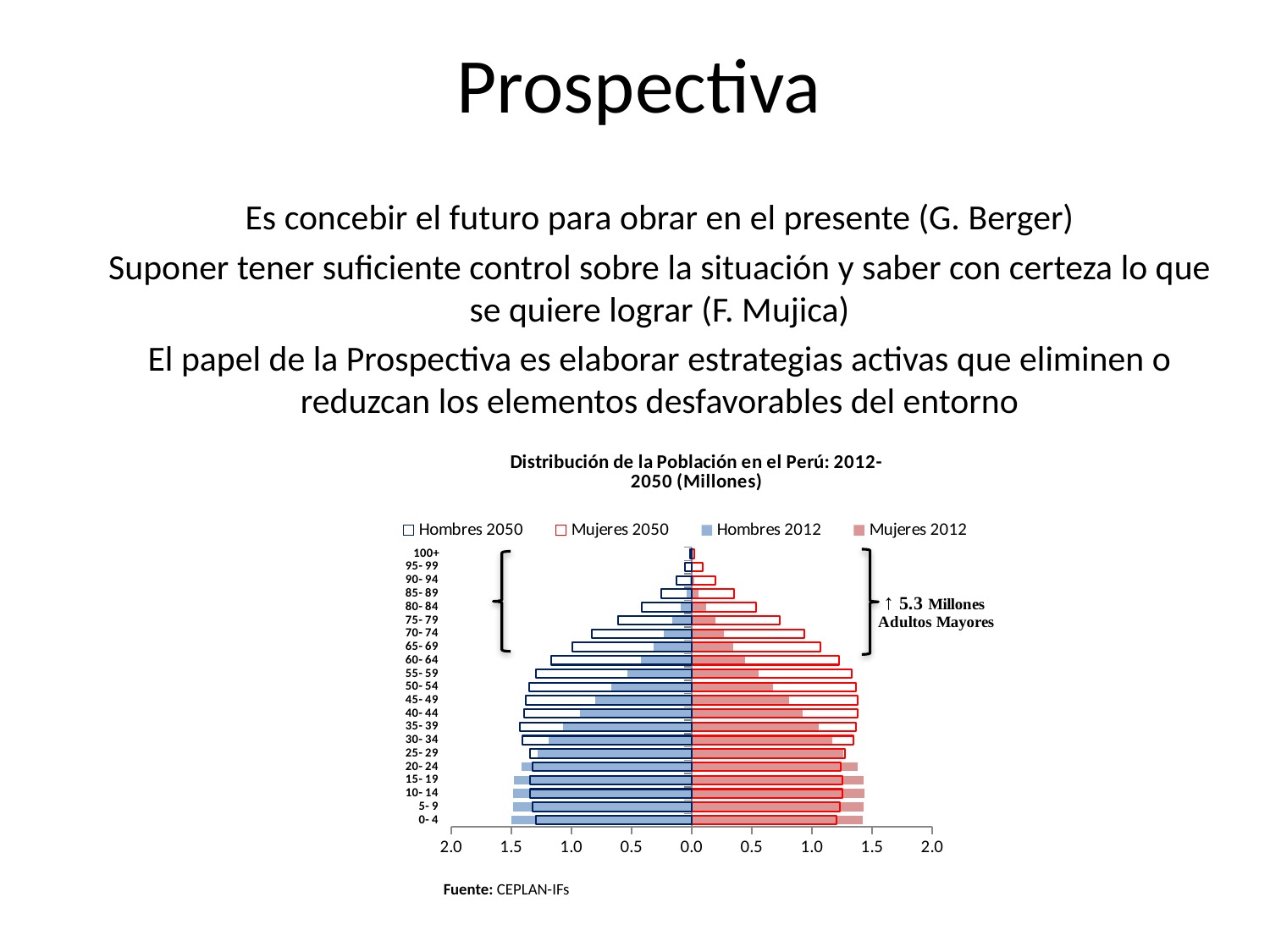
Is the Hombres 2012 value for the 0-4 age group greater or less than 1.0? greater Which age group has the smallest Hombres 2012 value? 100+ What kind of chart is shown on the slide? bar chart How many series does the legend of the population chart list? 4 Is the Hombres 2050 value for the 60-64 age group greater or less than 1.0? greater What is the title of the chart? Distribución de la Población en el Perú: 2012-2050 (Millones) For the 80-84 age group, which is larger: Hombres 2012 or Hombres 2050? Hombres 2050 What figure does the annotation on the right of the chart give for 'Adultos Mayores'? 5.3 Millones Is the Hombres 2012 value for the 80-84 age group greater or less than 0.5? less How many age groups are shown on the vertical axis of the population chart? 21 Do the Hombres 2012 values rise or fall as the age groups go from 0-4 up to 100+? fall